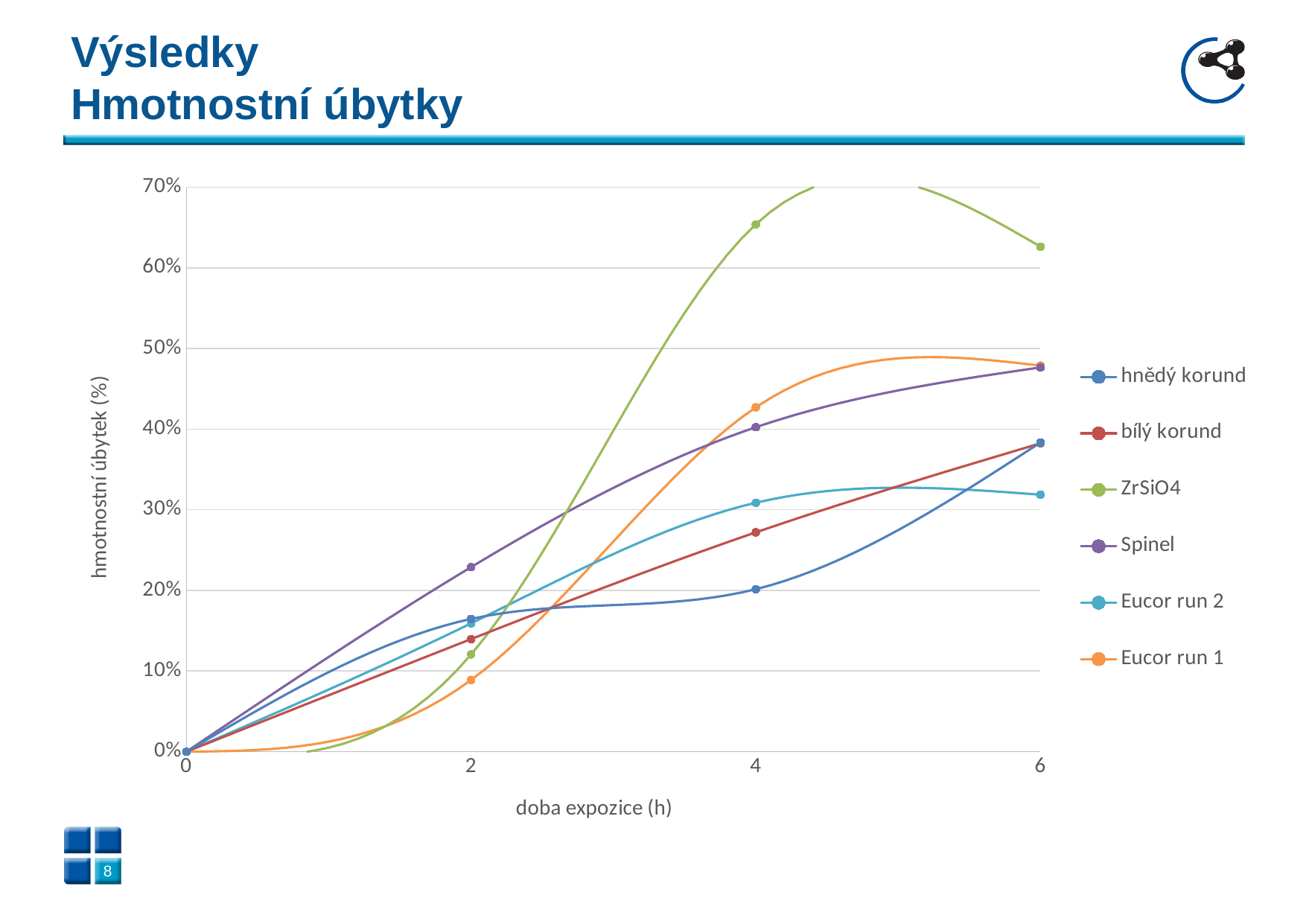
Which series has the lowest value at 6 h? Eucor run 2 What kind of chart is shown on the slide? line chart How many exposure-time points are plotted for each series? 4 Which is larger at 4 h, Eucor run 1 or Eucor run 2? Eucor run 1 How many series does the legend list? 6 Which series has the highest value at 4 h? ZrSiO4 What is the value for ZrSiO4 at 0 h? 0% Is the value for bílý korund at 4 h greater or less than 30%? less Which series has the lowest value at 4 h? hnědý korund Is the value for ZrSiO4 at 4 h greater or less than 60%? greater Does the value for hnědý korund rise or fall from 0 h to 6 h? rise What is the label of the y axis? hmotnostní úbytek (%)